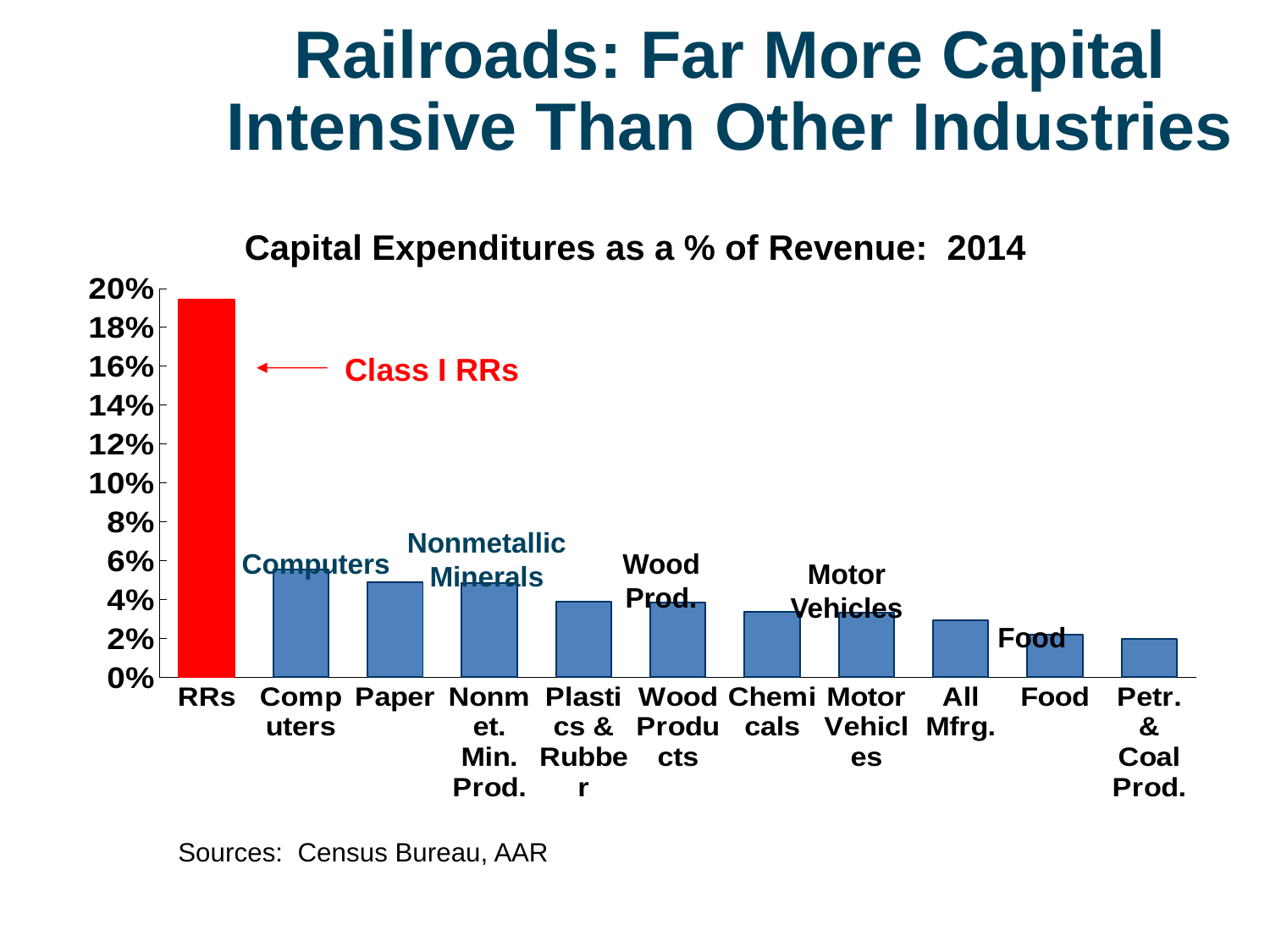
Is the value for RRs greater or less than 18%? greater Do the values generally rise or fall moving from left to right along the x axis? Fall Which bar is highlighted in red and labelled with the annotation "Class I RRs"? RRs Is the value for Computers greater or less than 4%? greater Is the value for Chemicals greater or less than 6%? less What kind of chart is shown on the slide? Bar chart Which category has the highest capital expenditures as a % of revenue? RRs How many categories are plotted on the chart? 11 Which is larger, the value for Computers or the value for Food? Computers What is the title of the chart? Capital Expenditures as a % of Revenue: 2014